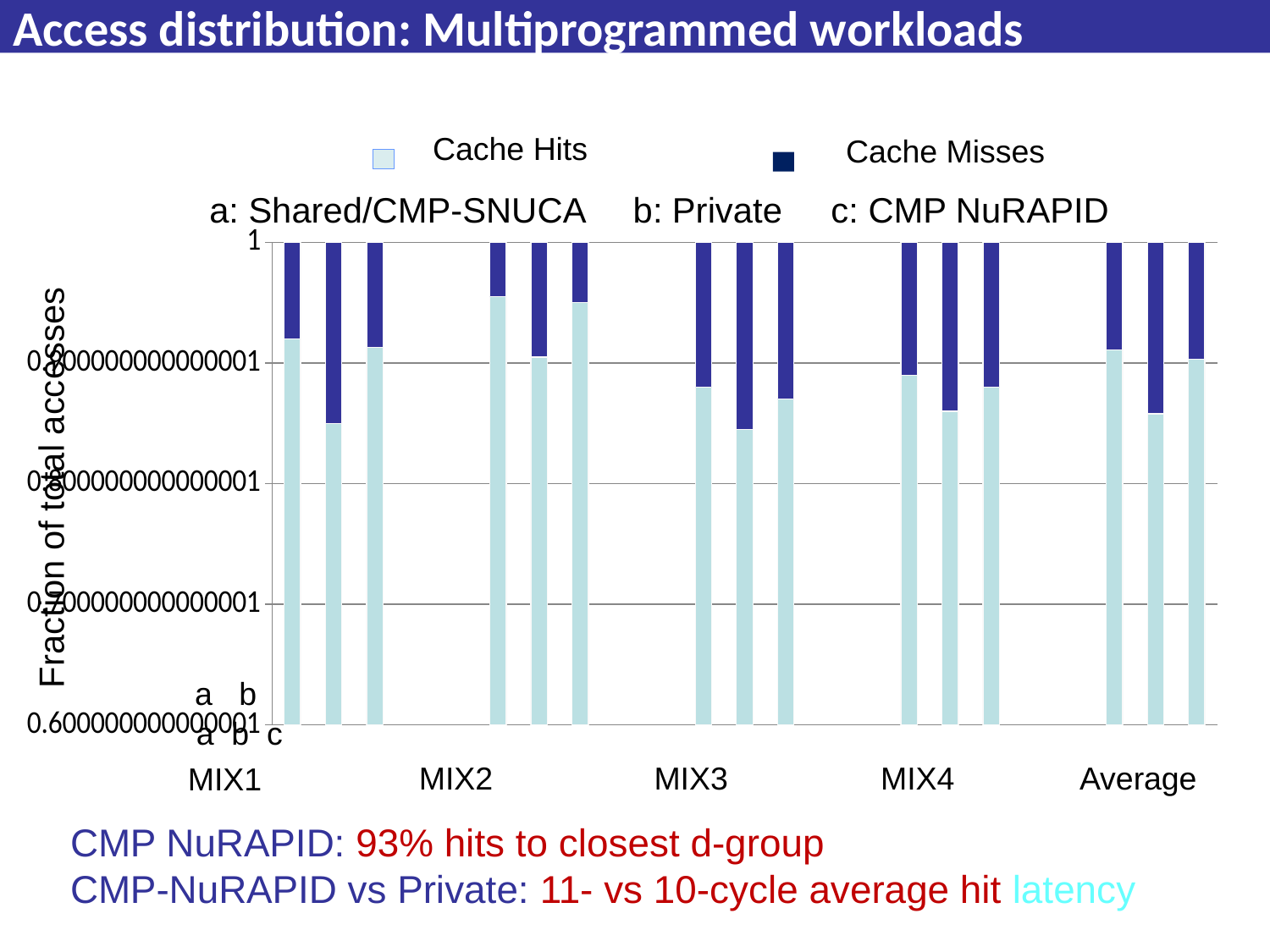
Is the Cache Hits fraction for the Private (b) bar in MIX3 greater or less than 0.9? less Which configuration does the bar labelled 'c' represent? CMP NuRAPID Is the Cache Hits fraction for the Shared/CMP-SNUCA (a) bar in MIX2 greater or less than 0.9? greater How many workload categories are shown along the x axis? 5 How many bars are plotted in total on the chart? 15 What kind of chart is shown on the slide? Stacked bar chart In MIX1, which has the larger Cache Hits fraction: the Shared/CMP-SNUCA (a) bar or the Private (b) bar? Shared/CMP-SNUCA (a) What are the two series named in the legend? Cache Hits and Cache Misses Is the Cache Hits fraction for the Private (b) bar in Average greater or less than 0.9? less Among the Private (b) bars, which workload has the highest Cache Hits fraction? MIX2 How many series does the legend list? 2